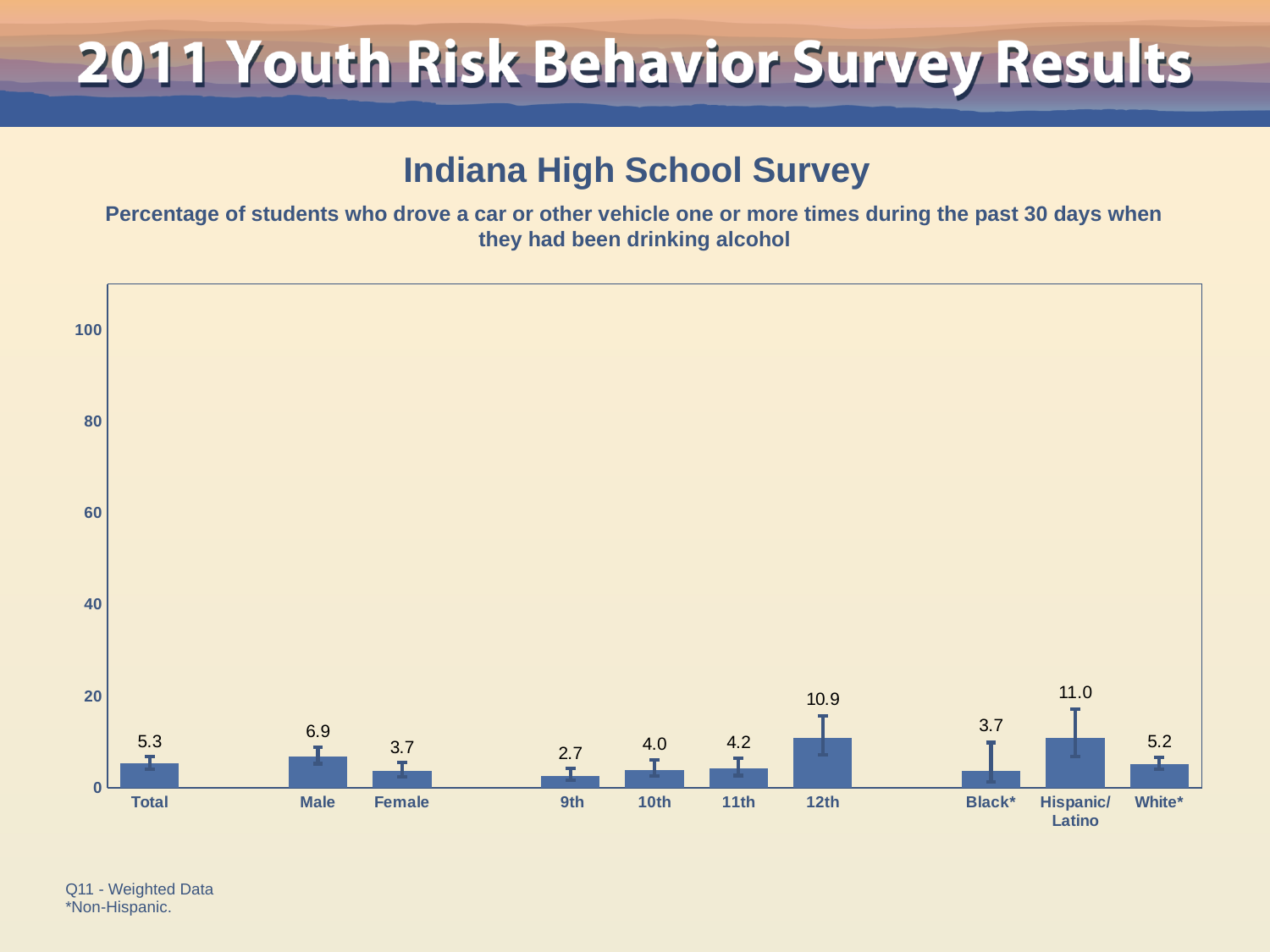
What is the value for Hispanic/Latino students? 11.0 How many categories are shown on the x axis? 10 What is the difference between the Male and Female values? 3.2 Is the value for 12th grade greater or less than 20? less Which category has the highest value? Hispanic/Latino What is the title of the chart? Indiana High School Survey Do the values rise or fall from 9th grade to 12th grade? rise What is the value for 12th grade? 10.9 Which is larger, the value for 10th grade or 11th grade? 11th Which category has the lowest value? 9th What is the value for Total? 5.3 What kind of chart is this? bar chart